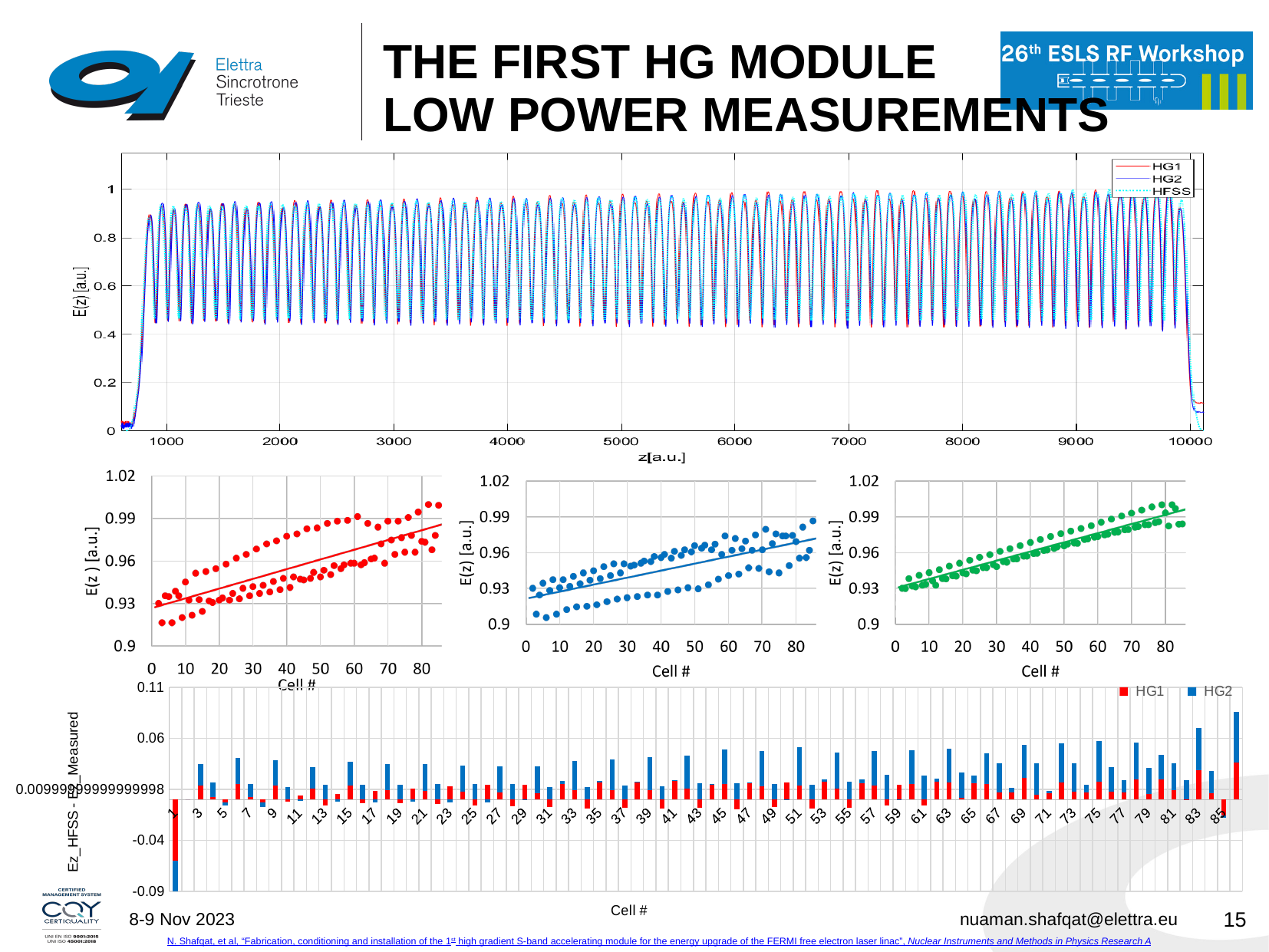
In the top chart (E(z) versus z), what are the names of the series in the legend? HG1, HG2, HFSS In the bottom bar chart, is the HG1 value for cell 1 greater or less than -0.04? less What kind of chart is the bottom chart showing Ez_HFSS - Ez_Measured against Cell #? bar chart In the bottom bar chart (Ez_HFSS - Ez_Measured), how many series does the legend list? 2 What kind of chart is the top chart showing E(z) against z? line chart In the top chart, what is the label of the x axis? z[a.u.] In the bottom bar chart, is the HG2 value for cell 85 greater or less than 0.06? less In the top chart (E(z) versus z), how many series does the legend list? 3 In the middle-left scatter chart (red points, E(z) versus Cell #), do the values generally rise or fall as Cell # increases? rise In the middle-right scatter chart (green points, E(z) versus Cell #), do the values generally rise or fall as Cell # increases? rise What kind of chart is the middle-centre chart with blue points showing E(z) against Cell #? scatter chart